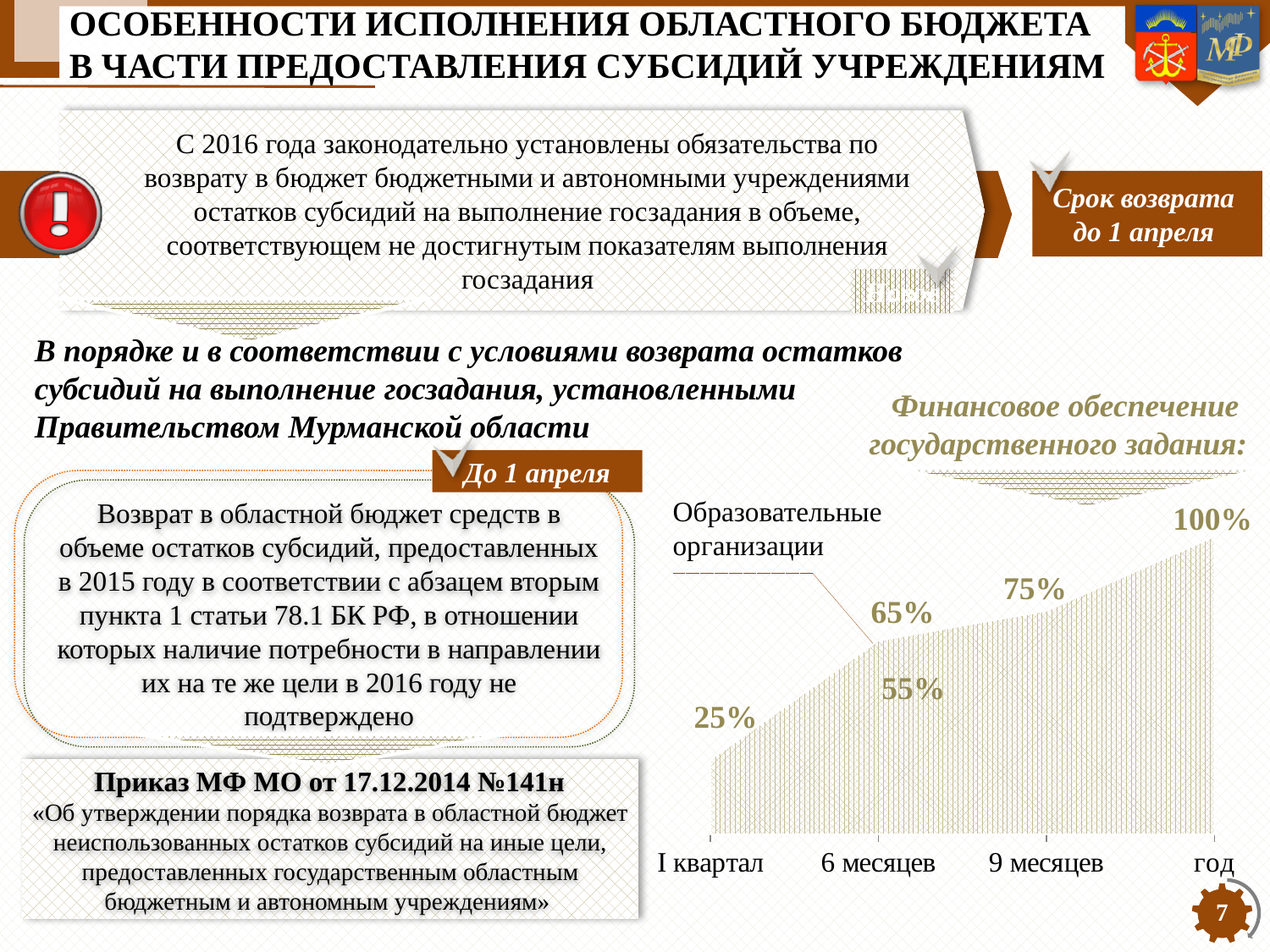
Which x-axis category has the highest value in the chart? год Do the values in the chart rise or fall from I квартал to год? rise What is the difference between the two values labelled at 6 месяцев (65% and 55%) in the chart? 10% What is the title of the chart on the slide? Финансовое обеспечение государственного задания: What value is labelled for Образовательные организации at 6 месяцев in the chart? 65% What value is shown for год in the chart? 100% What value is shown for 9 месяцев in the chart? 75% How many categories are shown on the x axis of the chart? 4 What kind of chart is shown on the slide? area chart What value is shown for I квартал in the chart? 25% Which x-axis category has the lowest value in the chart? I квартал What is the difference between the value for год and the value for I квартал in the chart? 75%